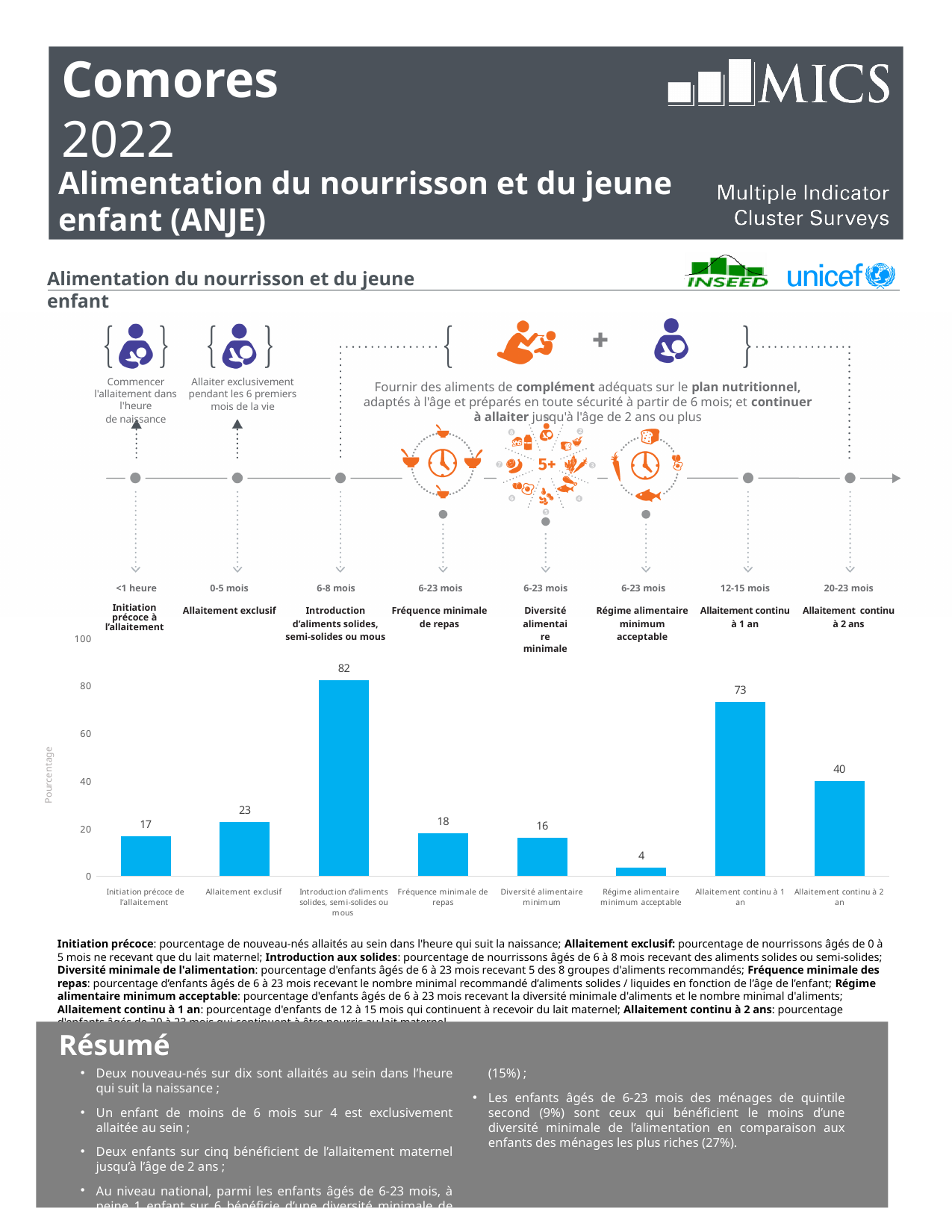
What is the value for "Introduction d'aliments solides, semi-solides ou mous"? 82 Which category has the highest value? Introduction d'aliments solides, semi-solides ou mous What is the label of the vertical axis of the chart? Pourcentage What is the value for "Allaitement continu à 1 an"? 73 Is the value for "Allaitement continu à 2 an" greater or less than 60? less What kind of chart is shown on the slide? bar chart What is the value for "Allaitement exclusif"? 23 Which is larger, the value for "Initiation précoce de l'allaitement" or the value for "Allaitement exclusif"? Allaitement exclusif How many categories are shown in the bar chart? 8 Which category has the lowest value? Régime alimentaire minimum acceptable What is the value for "Régime alimentaire minimum acceptable"? 4 What is the difference between the values for "Allaitement continu à 1 an" and "Allaitement continu à 2 an"? 33